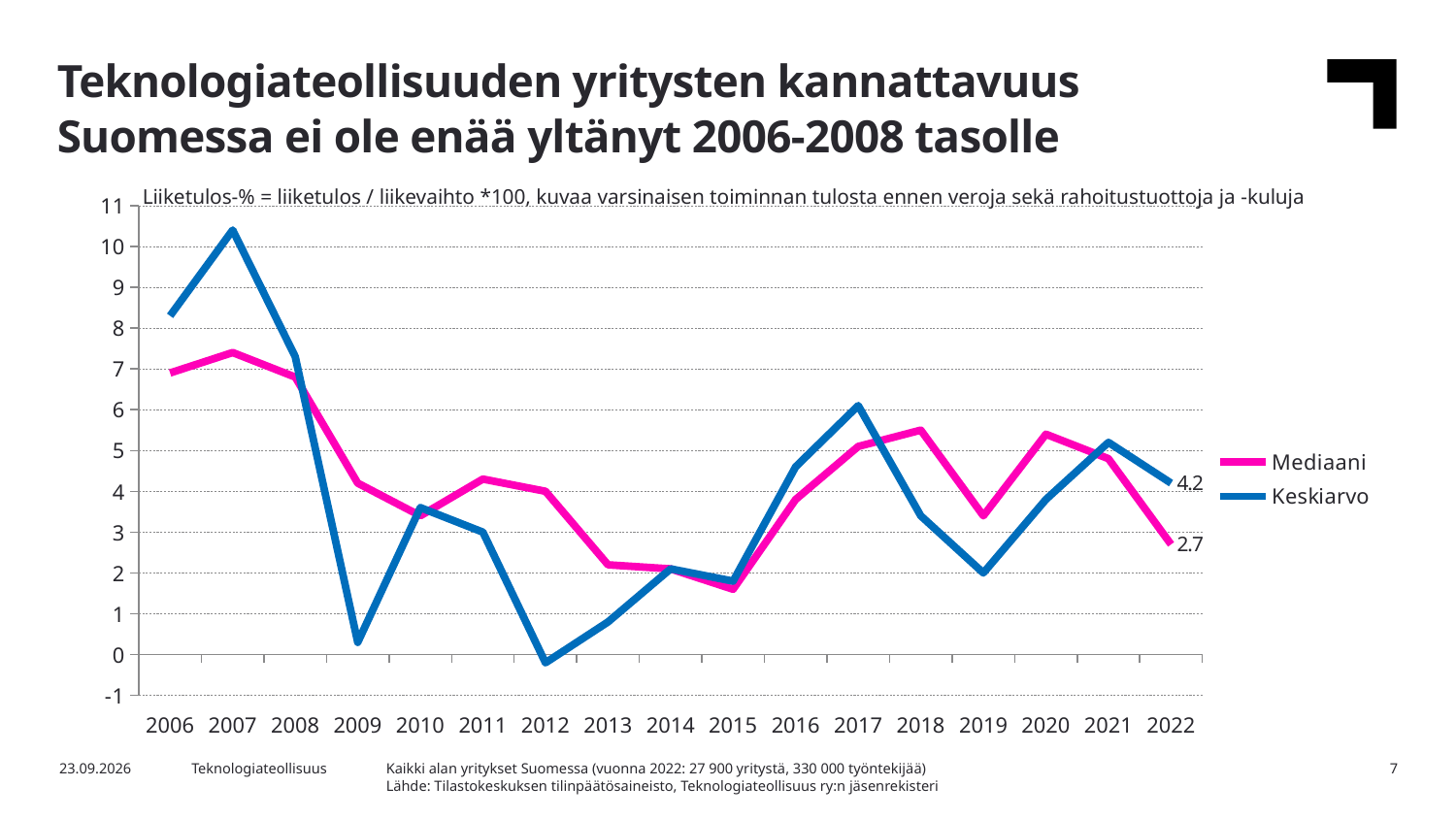
Is the value of Mediaani in 2013 greater or less than 3? less What is the value of Keskiarvo in 2022? 4.2 Does the Keskiarvo series rise or fall from 2007 to 2009? fall What is the value of Mediaani in 2022? 2.7 In which year does the Keskiarvo series reach its highest value? 2007 Is the value of Keskiarvo in 2007 greater or less than 10? greater How many series does the legend list? 2 What is the difference between Keskiarvo and Mediaani in 2022? 1.5 In 2022, which series has the higher value, Keskiarvo or Mediaani? Keskiarvo How many years are shown on the x axis? 17 Is the value of Keskiarvo in 2009 greater or less than 1? less What kind of chart is shown on the slide? line chart